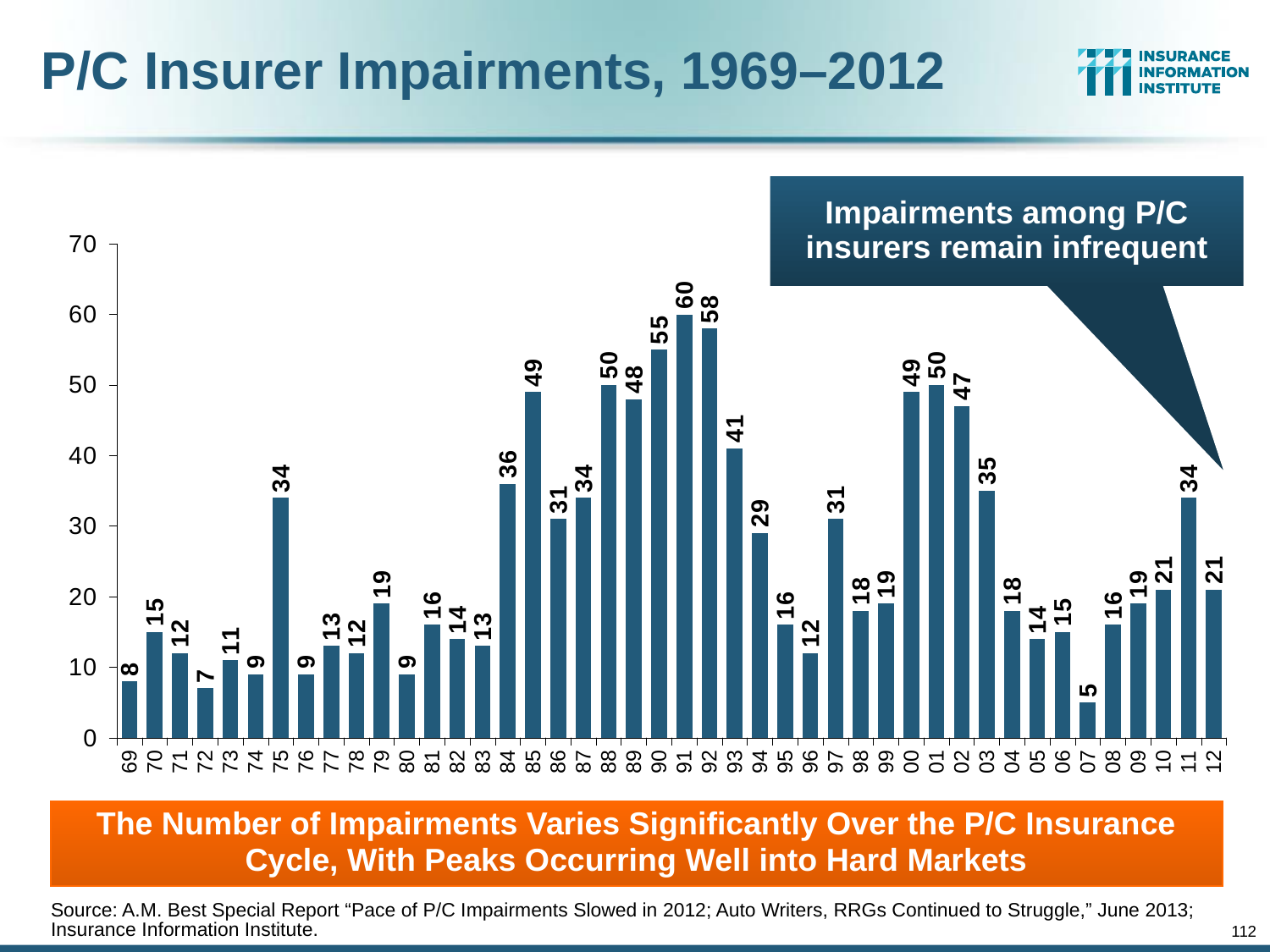
What is the difference between the impairments in 2001 and 2007? 45 What is the value shown for 2012? 21 What is the difference between the impairments in 1991 and 1992? 2 How many impairments are shown for 1975? 34 How many P/C insurer impairments were there in 1991? 60 Which year has the lowest number of impairments? 2007 Which year had more impairments, 1994 or 2011? 2011 Do the values rise or fall from 2007 to 2011? Rise Which year had more impairments, 1985 or 2002? 1985 What type of chart is shown on the slide? Bar chart How many years (bars) are plotted on the chart? 44 Which year has the highest number of impairments? 1991